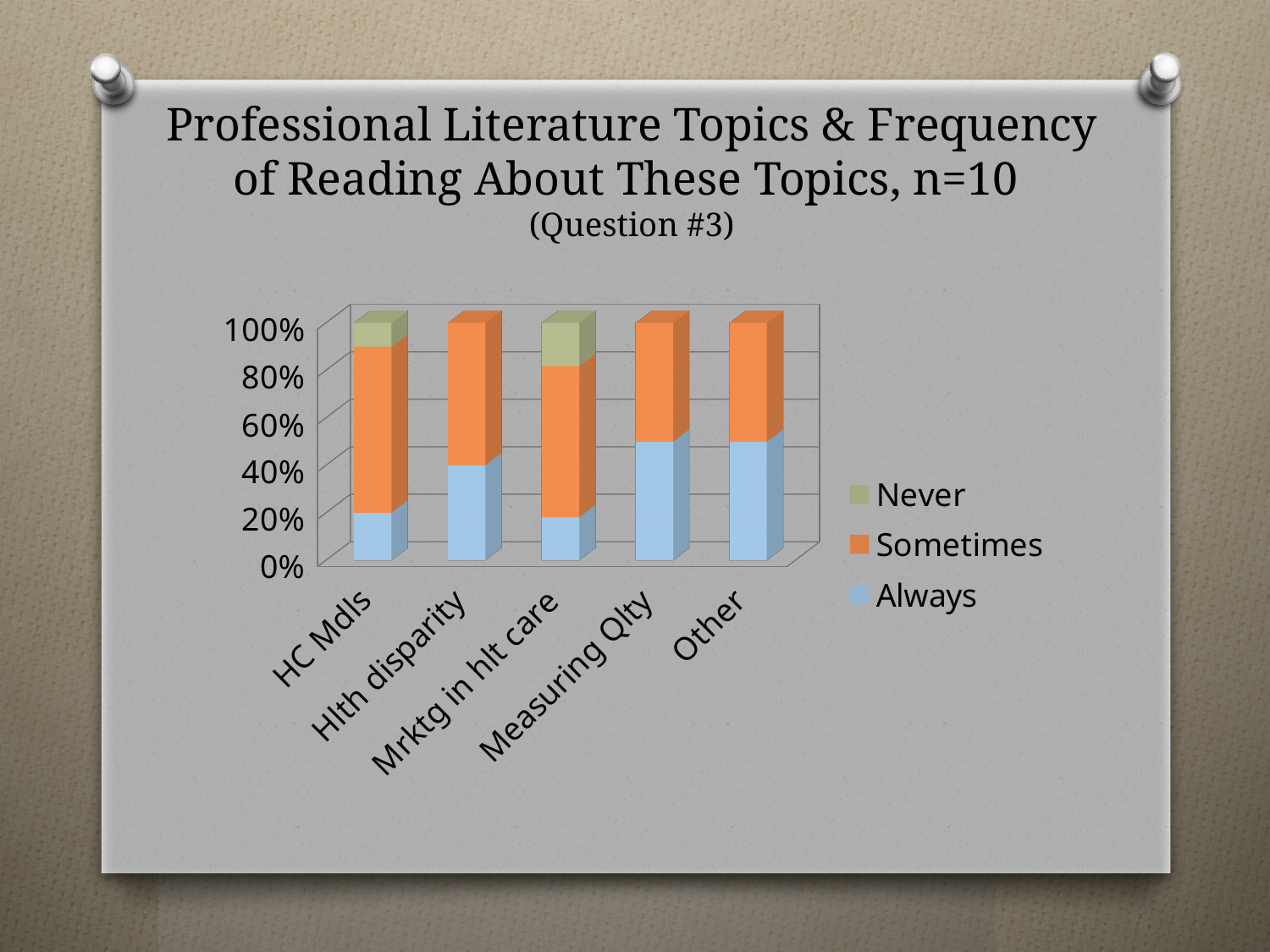
Is the Always value for Hlth disparity greater or less than 20%? greater How many series does the chart legend list? 3 Which series are listed in the chart legend? Never, Sometimes, Always What kind of chart is shown on the slide? Stacked bar chart Is the Always value for HC Mdls greater or less than 40%? less Is the Always value for Mrktg in hlt care greater or less than 40%? less How many categories are shown on the x axis of the chart? 5 Which is larger, the Always value for Measuring Qlty or for HC Mdls? Measuring Qlty Which category has the largest Never share? Mrktg in hlt care How many categories have no Never segment in their bar? 3 What is the title of the chart on the slide? Professional Literature Topics & Frequency of Reading About These Topics, n=10 (Question #3)